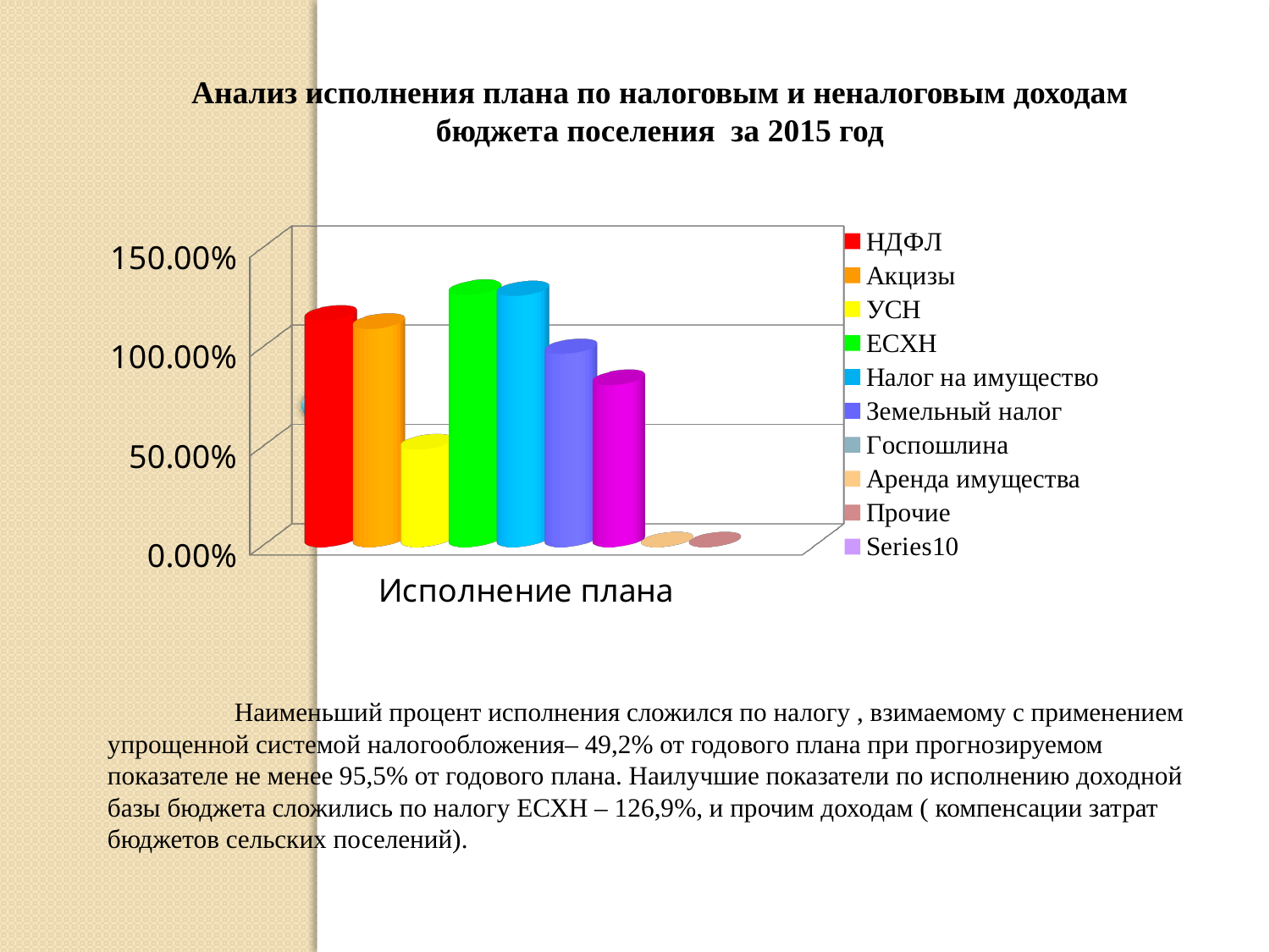
Is the value for НДФЛ greater or less than 100.00%? greater What kind of chart is shown on the slide? bar chart Is the value for ЕСХН greater or less than 100.00%? greater Is the value for Акцизы greater or less than 50.00%? greater Which is larger, the value for Налог на имущество or the value for УСН? Налог на имущество How many series does the chart legend list? 10 What is the category label shown on the x axis of the chart? Исполнение плана Which is larger, the value for НДФЛ or the value for УСН? НДФЛ Which is larger, the value for ЕСХН or the value for Акцизы? ЕСХН How many categories are shown on the x axis of the chart? 1 What is the last entry in the chart legend? Series10